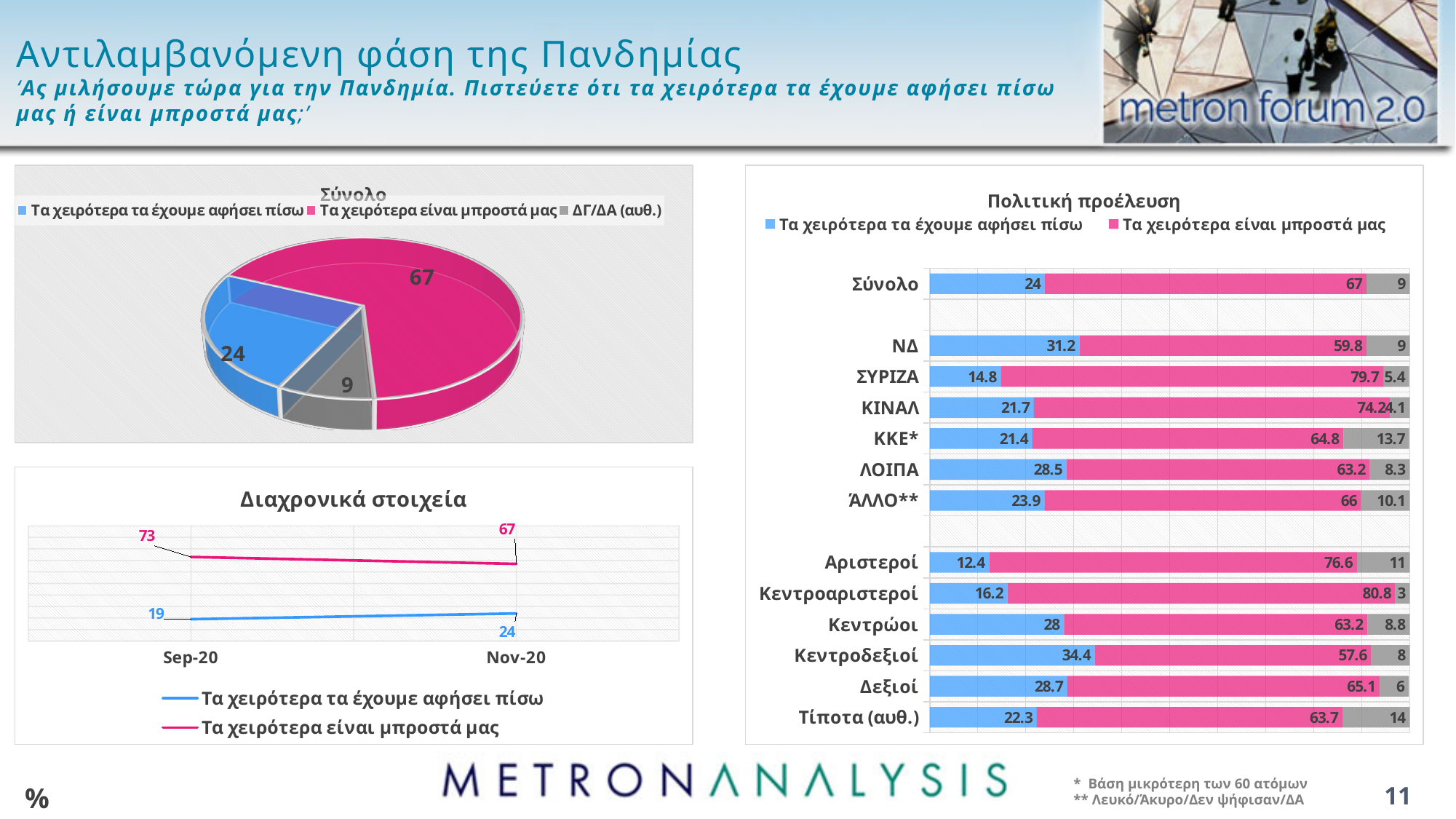
What kind of chart is the chart titled 'Σύνολο'? Pie chart In the chart titled 'Πολιτική προέλευση', which category has the highest value for 'Τα χειρότερα τα έχουμε αφήσει πίσω'? Κεντροδεξιοί In the chart titled 'Πολιτική προέλευση', which category has the lowest value for 'Τα χειρότερα τα έχουμε αφήσει πίσω'? Αριστεροί In the chart titled 'Διαχρονικά στοιχεία', what is the value for 'Τα χειρότερα είναι μπροστά μας' at Sep-20? 73 In the pie chart titled 'Σύνολο', which slice is the largest? Τα χειρότερα είναι μπροστά μας In the chart titled 'Διαχρονικά στοιχεία', does the line for 'Τα χειρότερα τα έχουμε αφήσει πίσω' rise or fall from Sep-20 to Nov-20? Rises In the chart titled 'Διαχρονικά στοιχεία', by how much did 'Τα χειρότερα είναι μπροστά μας' change from Sep-20 to Nov-20? 6 How many series does the legend of the chart titled 'Διαχρονικά στοιχεία' list? 2 In the pie chart titled 'Σύνολο', what is the value for 'Τα χειρότερα είναι μπροστά μας'? 67 In the chart titled 'Πολιτική προέλευση', which has the larger value for 'Τα χειρότερα είναι μπροστά μας', ΝΔ or ΚΚΕ*? ΚΚΕ* How many categories are shown in the chart titled 'Πολιτική προέλευση'? 13 In the chart titled 'Πολιτική προέλευση', what is the value of 'Τα χειρότερα είναι μπροστά μας' for ΣΥΡΙΖΑ? 79.7